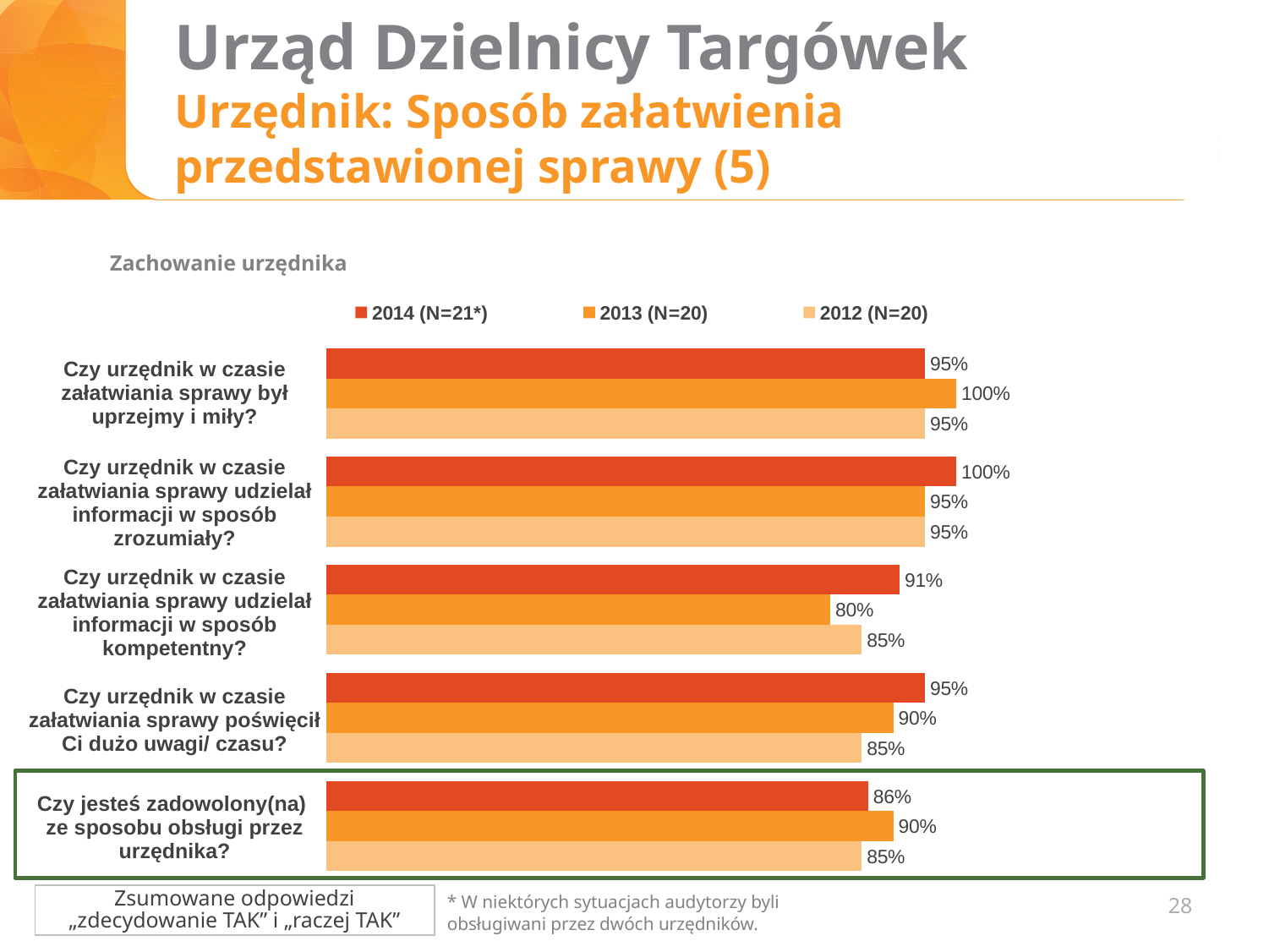
What type of chart is shown on the slide? bar chart Which category has the highest 2014 (N=21*) value? Czy urzędnik w czasie załatwiania sprawy udzielał informacji w sposób zrozumiały? How many question categories are plotted in the chart? 5 What is the 2013 (N=20) value for "Czy urzędnik w czasie załatwiania sprawy był uprzejmy i miły?"? 100% What is the 2014 (N=21*) value for "Czy urzędnik w czasie załatwiania sprawy udzielał informacji w sposób kompetentny?"? 91% How many series does the legend list? 3 What is the difference between the 2014 (N=21*) and 2012 (N=20) values for "Czy urzędnik w czasie załatwiania sprawy poświęcił Ci dużo uwagi/ czasu?"? 10% Which category has the lowest 2013 (N=20) value? Czy urzędnik w czasie załatwiania sprawy udzielał informacji w sposób kompetentny? What is the subtitle shown above the chart? Zachowanie urzędnika For "Czy jesteś zadowolony(na) ze sposobu obsługi przez urzędnika?", which is larger: the 2014 (N=21*) value or the 2013 (N=20) value? 2013 (N=20) What is the difference between the 2014 (N=21*) and 2013 (N=20) values for "Czy urzędnik w czasie załatwiania sprawy udzielał informacji w sposób kompetentny?"? 11% What is the 2012 (N=20) value for "Czy jesteś zadowolony(na) ze sposobu obsługi przez urzędnika?"? 85%